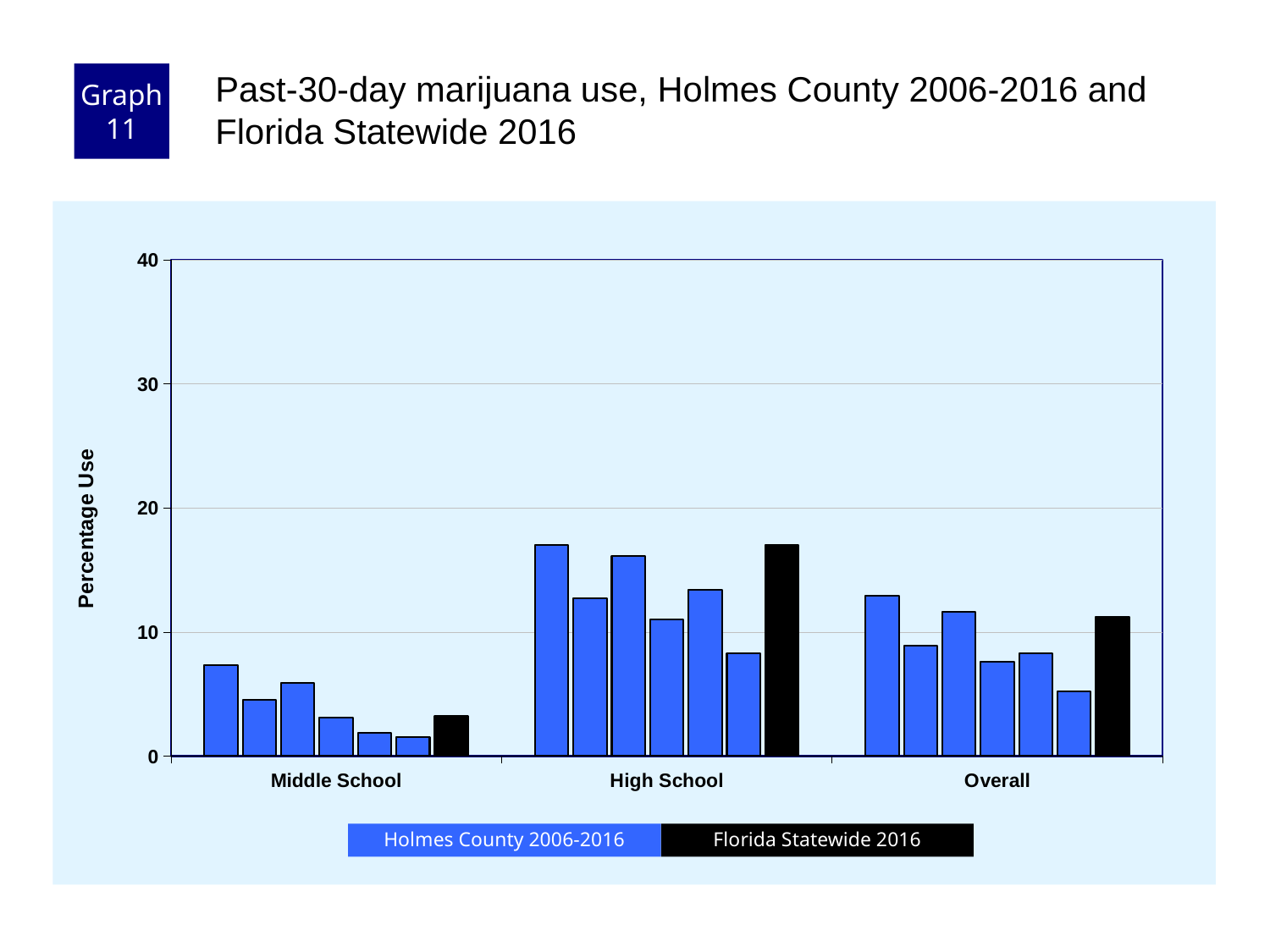
Which category has the highest bars overall? High School Which category has the lowest bars overall? Middle School Is the Florida Statewide 2016 value for High School greater or less than 10? greater Which is larger: the Florida Statewide 2016 value for High School or for Middle School? High School Is the Florida Statewide 2016 value for Middle School greater or less than 10? less What kind of chart is shown on the slide? bar chart What is the title of the y axis? Percentage Use Which colour represents Florida Statewide 2016 in the legend? black Is the Florida Statewide 2016 value for Overall greater or less than 20? less How many categories are shown on the x axis? 3 How many series does the legend list? 2